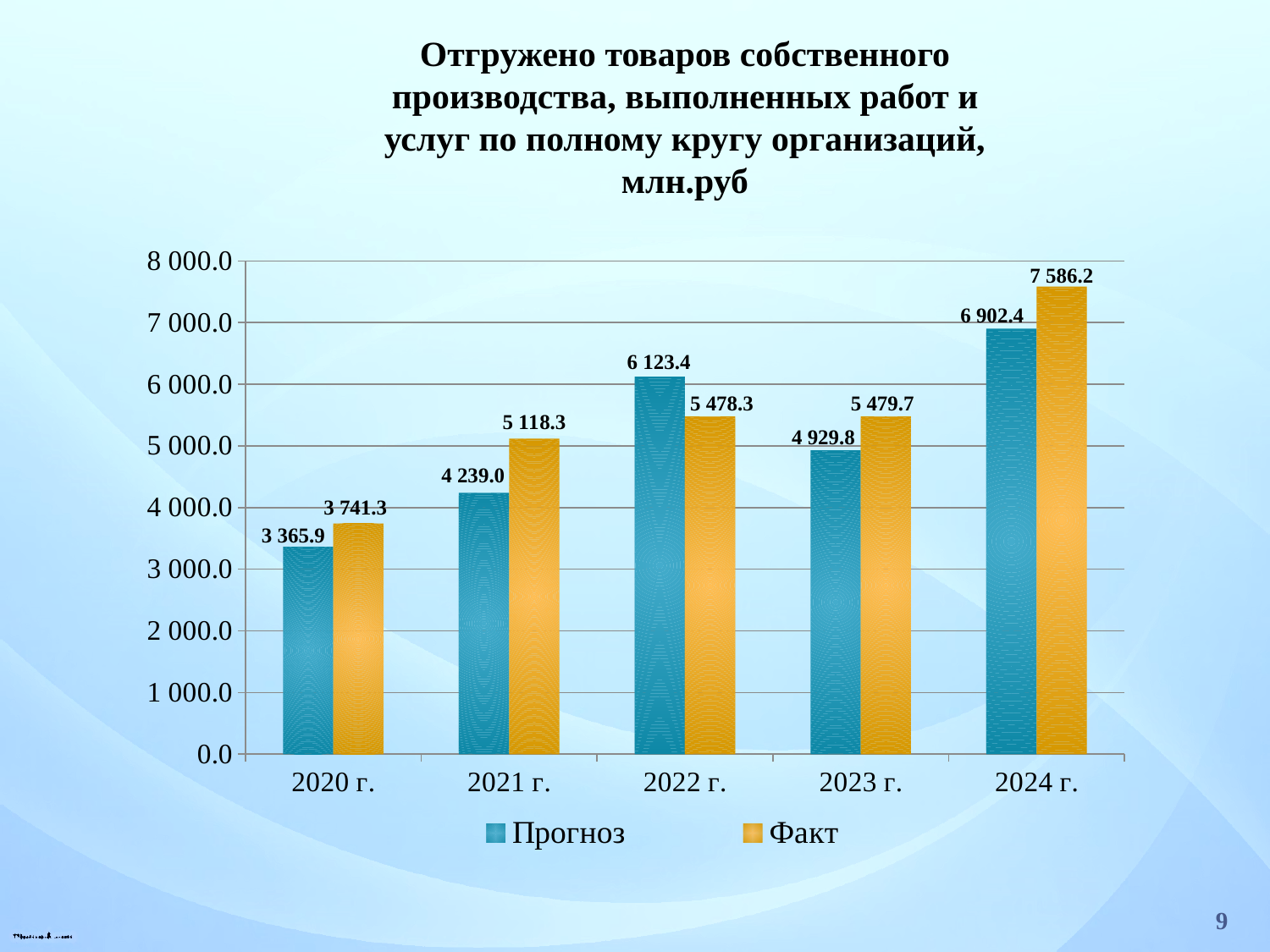
How many series does the legend list? 2 What is the Факт value for 2024 г.? 7 586.2 What is the Прогноз value for 2021 г.? 4 239.0 In which year is the Прогноз value the lowest? 2020 г. In which year is the Факт value the highest? 2024 г. For 2022 г., which is larger: Прогноз or Факт? Прогноз How many years are shown on the x axis? 5 Do the Факт values rise or fall from 2020 г. to 2024 г.? rise What is the Прогноз value for 2023 г.? 4 929.8 What is the difference between the Факт and Прогноз values for 2024 г.? 683.8 Is the Прогноз value for 2024 г. greater or less than 7 000.0? less What is the difference between the Прогноз and Факт values for 2022 г.? 645.1